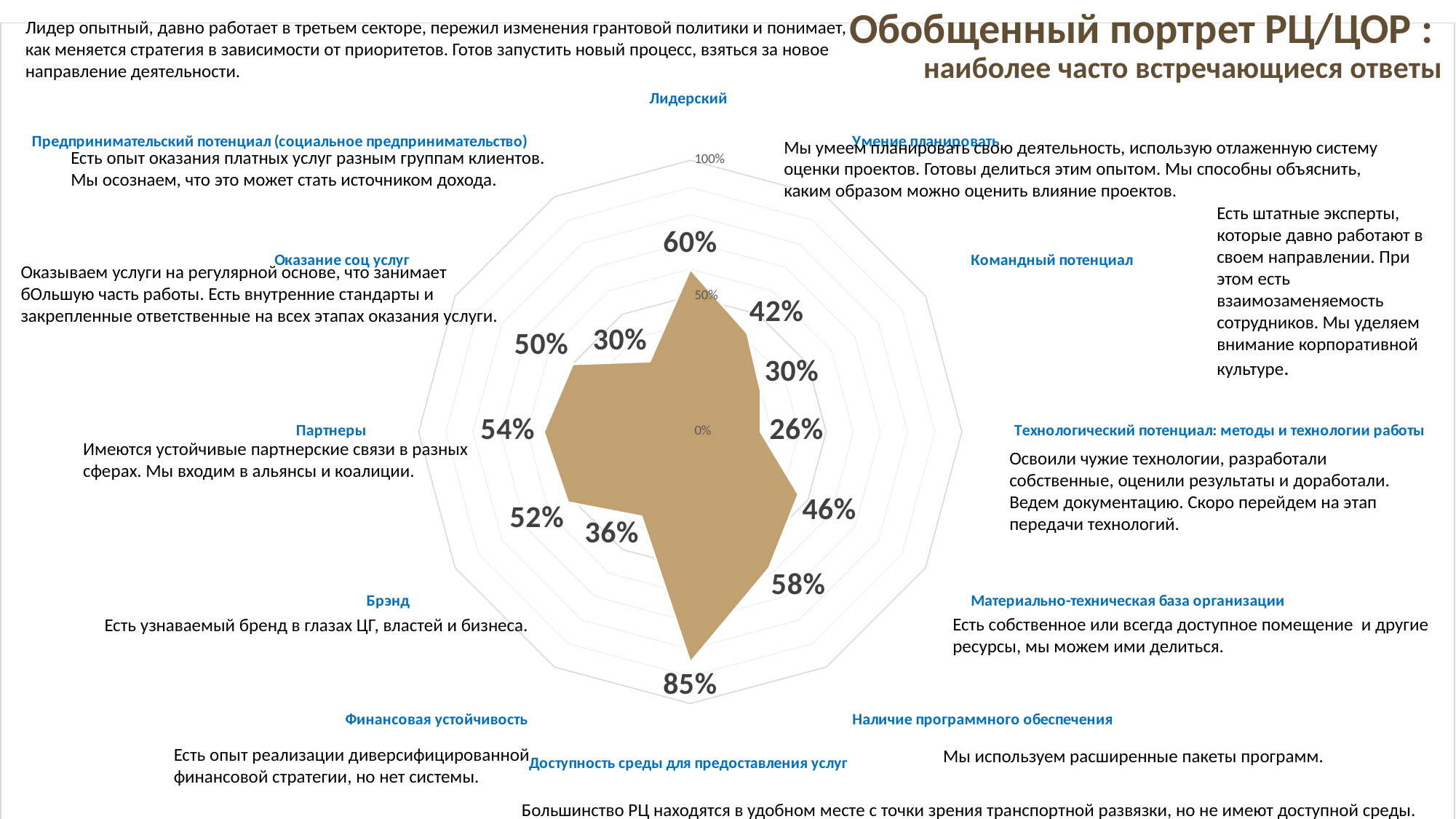
Which is larger, the value for Брэнд or the value for Финансовая устойчивость? Брэнд What is the value for Лидерский? 60% What is the value for Доступность среды для предоставления услуг? 85% How many categories (axes) does the radar chart have? 12 What is the value for Партнеры? 54% What is the value for Технологический потенциал: методы и технологии работы? 26% What is the difference between the values for Доступность среды для предоставления услуг and Лидерский? 25% What is the maximum value shown on the chart's axis scale? 100% What type of chart is shown on the slide? Radar chart Which category has the lowest value? Технологический потенциал: методы и технологии работы Is the value for Наличие программного обеспечения greater or less than 50%? greater Which category has the highest value? Доступность среды для предоставления услуг